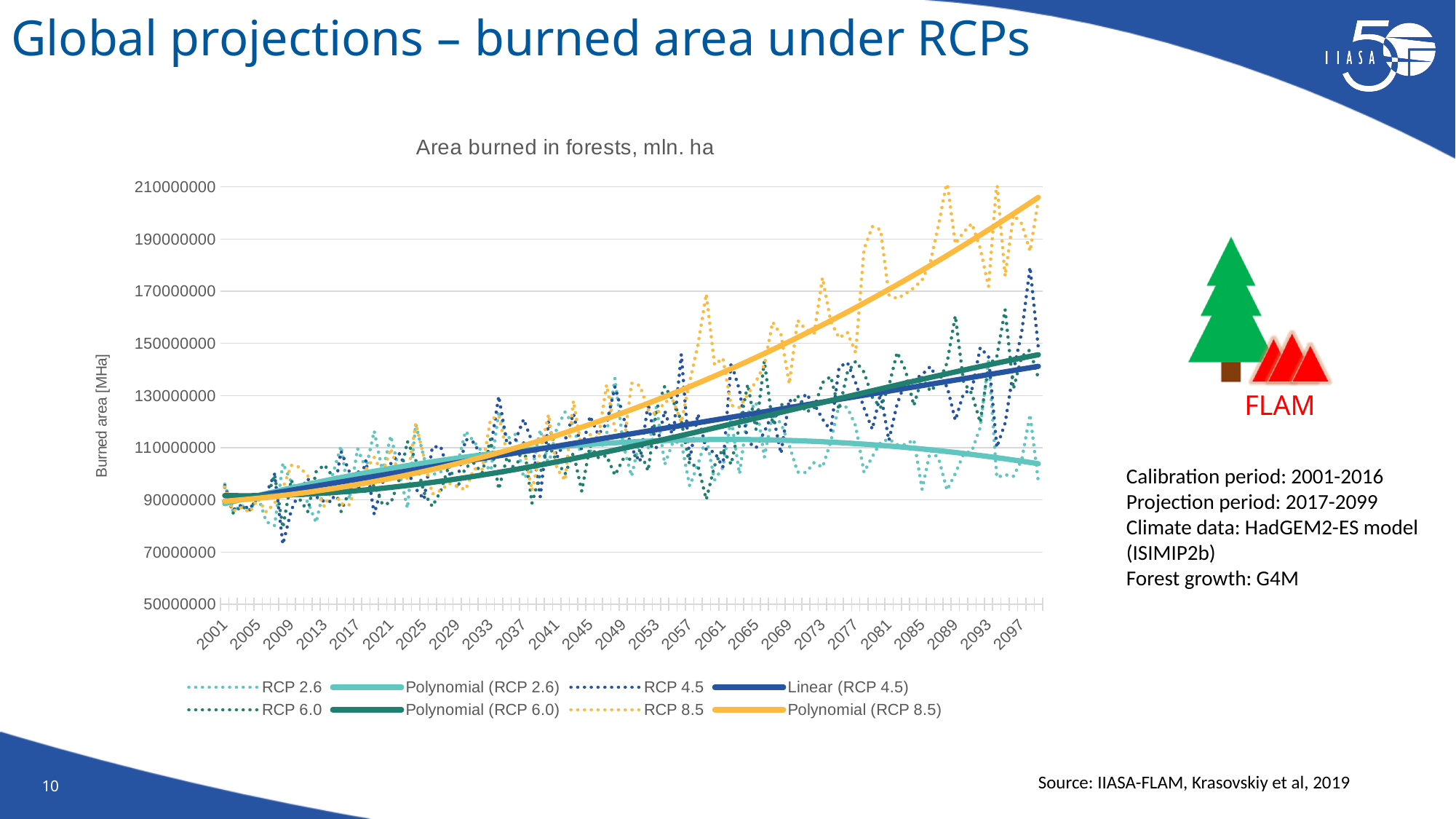
What is the highest value shown on the vertical axis of the chart? 210000000 At 2097, which is larger: the Polynomial (RCP 8.5) line or the Polynomial (RCP 2.6) line? Polynomial (RCP 8.5) What kind of chart is shown on the slide? line chart Is the value of the Polynomial (RCP 8.5) line at 2097 greater or less than 190000000? greater Is the value of the Polynomial (RCP 2.6) line at 2097 greater or less than 110000000? less Is the value of the Linear (RCP 4.5) line at 2097 greater or less than 130000000? greater Which trend line reaches the highest value at the end of the projection period (2097)? Polynomial (RCP 8.5) How many series does the chart legend list? 8 What is the label on the vertical axis of the chart? Burned area [MHa] Does the Polynomial (RCP 8.5) trend line rise or fall from 2001 to 2097? rise Which trend line has the lowest value at the end of the projection period (2097)? Polynomial (RCP 2.6) What is the title of the chart? Area burned in forests, mln. ha